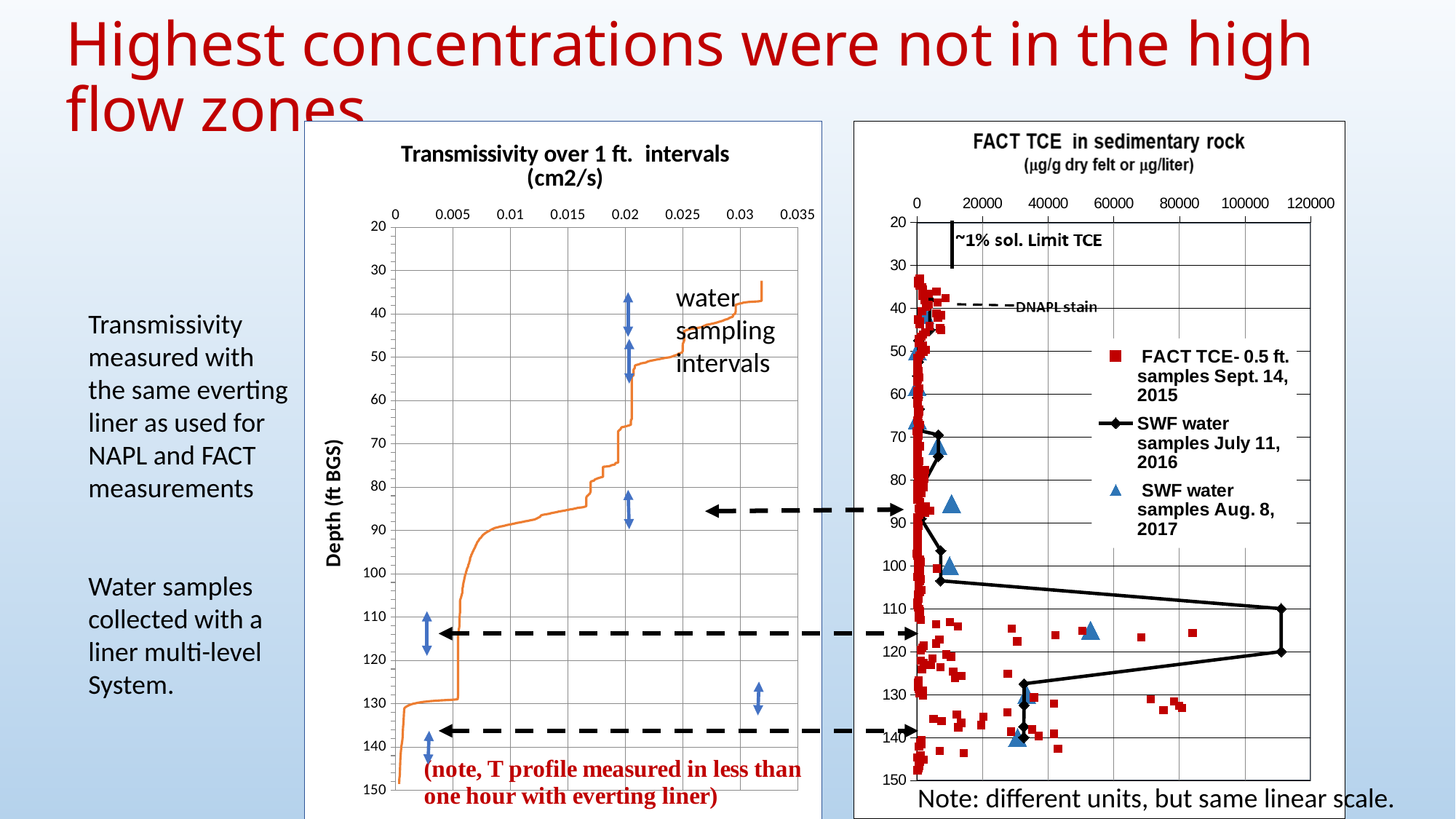
On the right chart (FACT TCE in sedimentary rock), what is the largest value shown on the horizontal axis? 120000 On the left chart (Transmissivity over 1 ft. intervals), is the transmissivity at a depth of 60 ft greater or less than 0.015? greater On the left chart (Transmissivity over 1 ft. intervals), does transmissivity generally increase or decrease as depth increases from 30 ft to 150 ft? decrease On the left chart (Transmissivity over 1 ft. intervals), what is the label of the vertical axis? Depth (ft BGS) On the right chart (FACT TCE in sedimentary rock), is the SWF water sample July 11, 2016 value at a depth of 110 ft greater or less than 100000? greater On the left chart (Transmissivity over 1 ft. intervals), which depth has the higher transmissivity: 40 ft or 100 ft? 40 ft On the right chart (FACT TCE in sedimentary rock), is the SWF water sample Aug. 8, 2017 value at a depth of about 115 ft greater or less than 40000? greater On the left chart (Transmissivity over 1 ft. intervals), what is the largest value shown on the horizontal axis? 0.035 What kind of chart is the right chart titled 'FACT TCE in sedimentary rock'? scatter chart What kind of chart is the left chart titled 'Transmissivity over 1 ft. intervals (cm2/s)'? line chart How many series does the legend of the right chart 'FACT TCE in sedimentary rock' list? 3